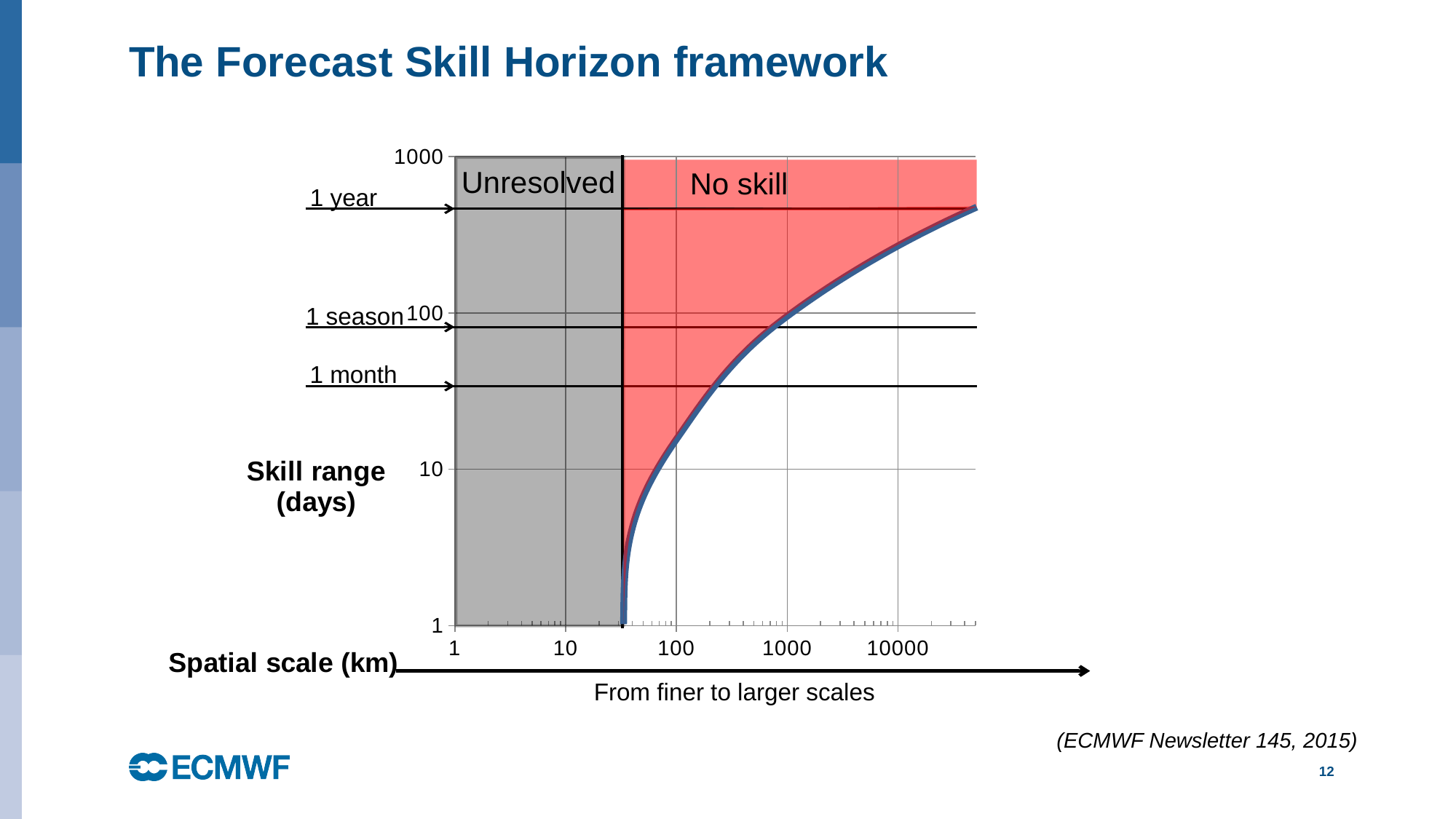
Which spatial scale is larger on the horizontal axis, 1000 km or 10000 km? 10000 km What is the label of the horizontal axis? Spatial scale (km) At a spatial scale of 100 km, is the skill range on the curve greater or less than 100 days? less At a spatial scale of 10000 km, is the skill range on the curve greater or less than 100 days? greater Does the skill range curve rise or fall as spatial scale increases along the x axis? rise What kind of chart is shown on the slide? line chart What is the highest value labelled on the vertical axis? 1000 How many labelled tick values are shown on the vertical axis? 4 What is the lowest value labelled on the horizontal axis? 1 How many labelled tick values are shown on the horizontal axis? 5 What is the label of the vertical axis? Skill range (days) At a spatial scale of 10000 km, is the skill range on the curve greater or less than 1000 days? less